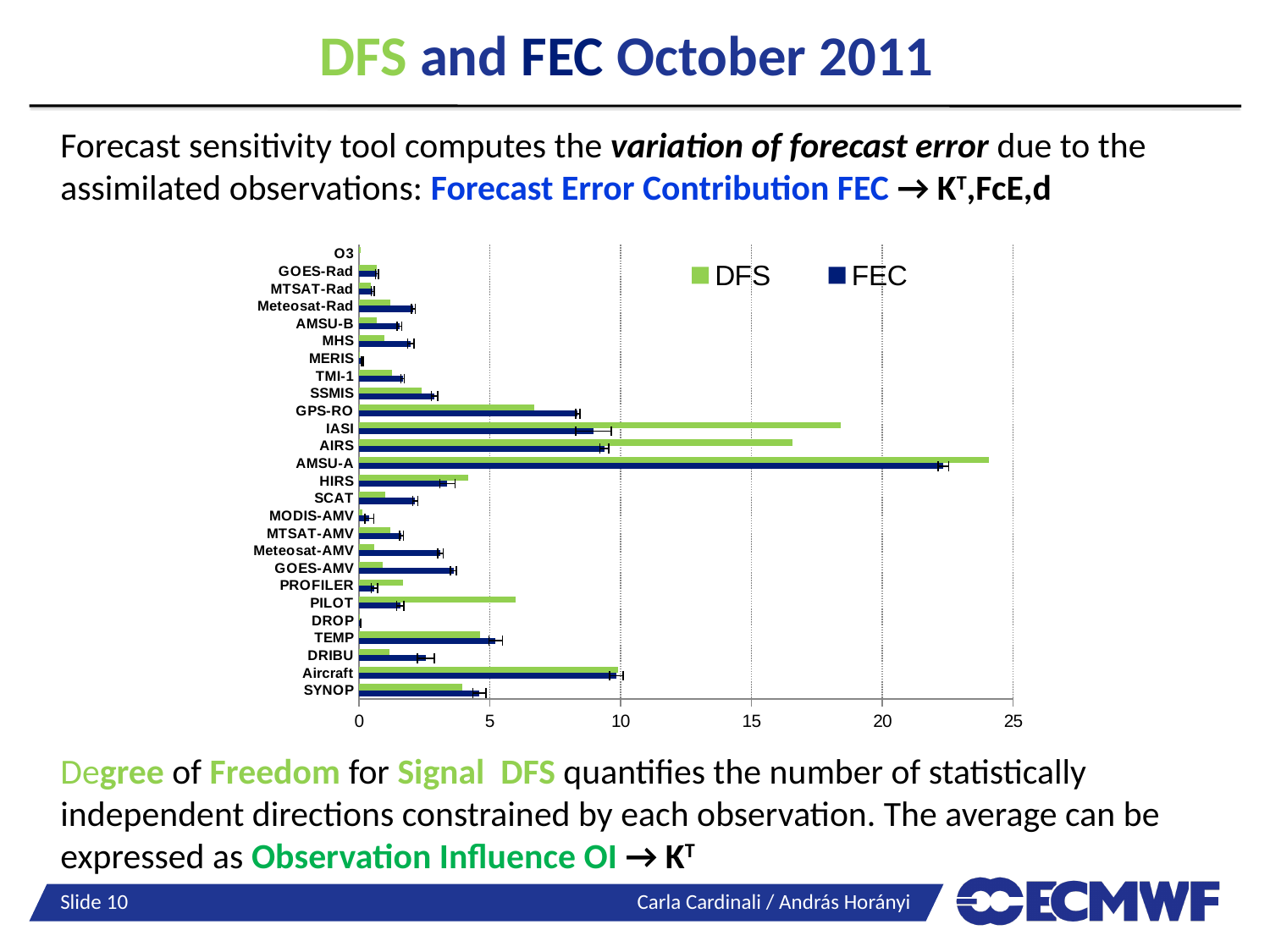
Is the DFS value for IASI greater or less than 15? greater What kind of chart is shown on the slide? bar chart How many series does the chart legend list? 2 For IASI, which is larger, the DFS value or the FEC value? DFS Is the DFS value for PILOT greater or less than 5? greater Is the FEC value for GPS-RO greater or less than 10? less For GPS-RO, which is larger, the DFS value or the FEC value? FEC What are the two series named in the chart legend? DFS and FEC Which category has the highest FEC value? AMSU-A Which category has the highest DFS value? AMSU-A How many observation categories are plotted on the chart? 26